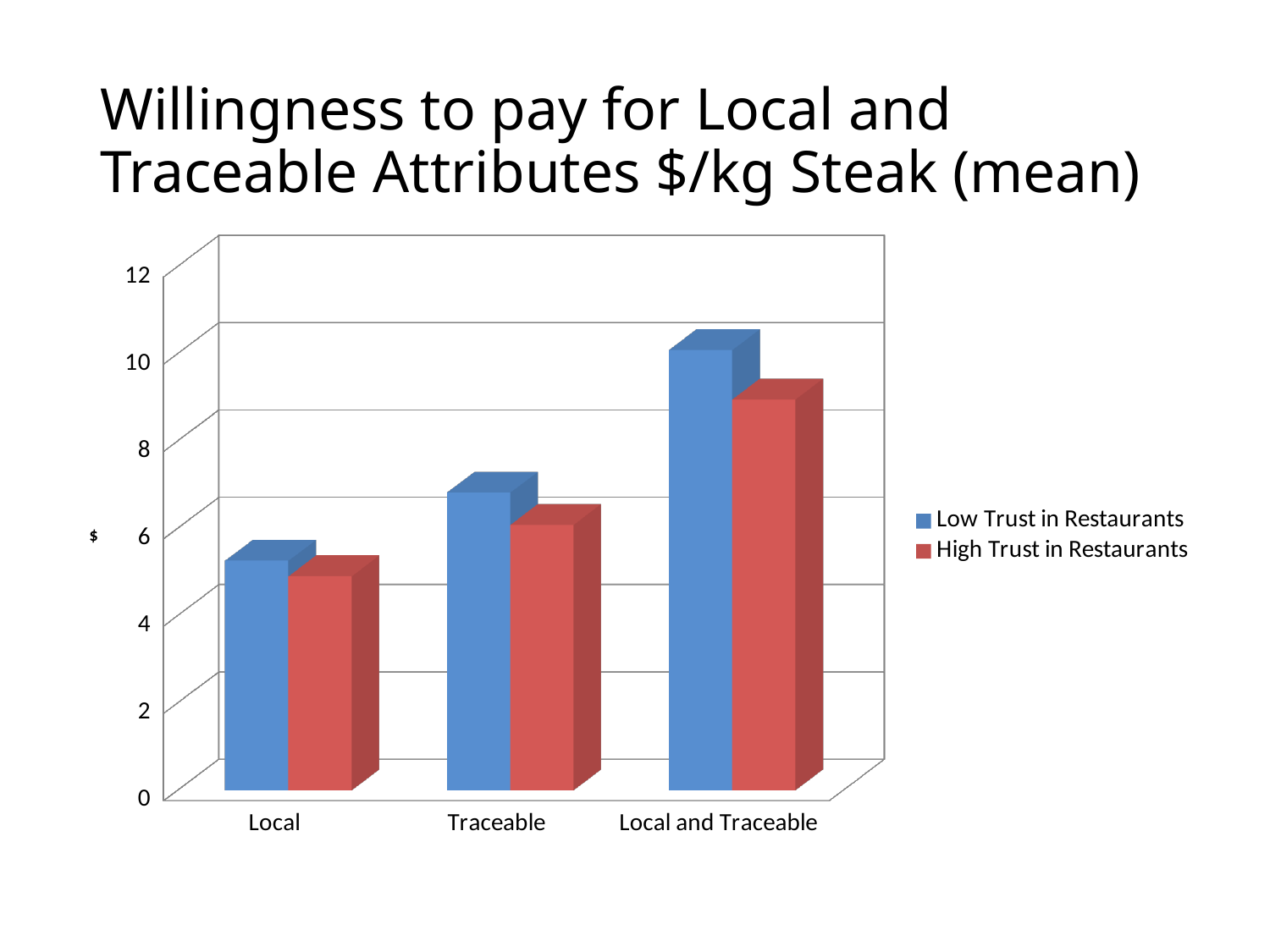
Is the Low Trust in Restaurants value for Local and Traceable greater or less than 8? greater Which category has the lowest High Trust in Restaurants value? Local Do the Low Trust in Restaurants values rise or fall from Local to Local and Traceable along the x axis? rise How many categories are shown on the x axis of the chart? 3 How many series does the chart's legend list? 2 For Local and Traceable, which series has the larger value: Low Trust in Restaurants or High Trust in Restaurants? Low Trust in Restaurants Is the High Trust in Restaurants value for Local and Traceable greater or less than 10? less Is the Low Trust in Restaurants value for Traceable greater or less than 6? greater Which category has the highest Low Trust in Restaurants value? Local and Traceable For Traceable, which series has the larger value: Low Trust in Restaurants or High Trust in Restaurants? Low Trust in Restaurants What kind of chart is shown on the slide? bar chart